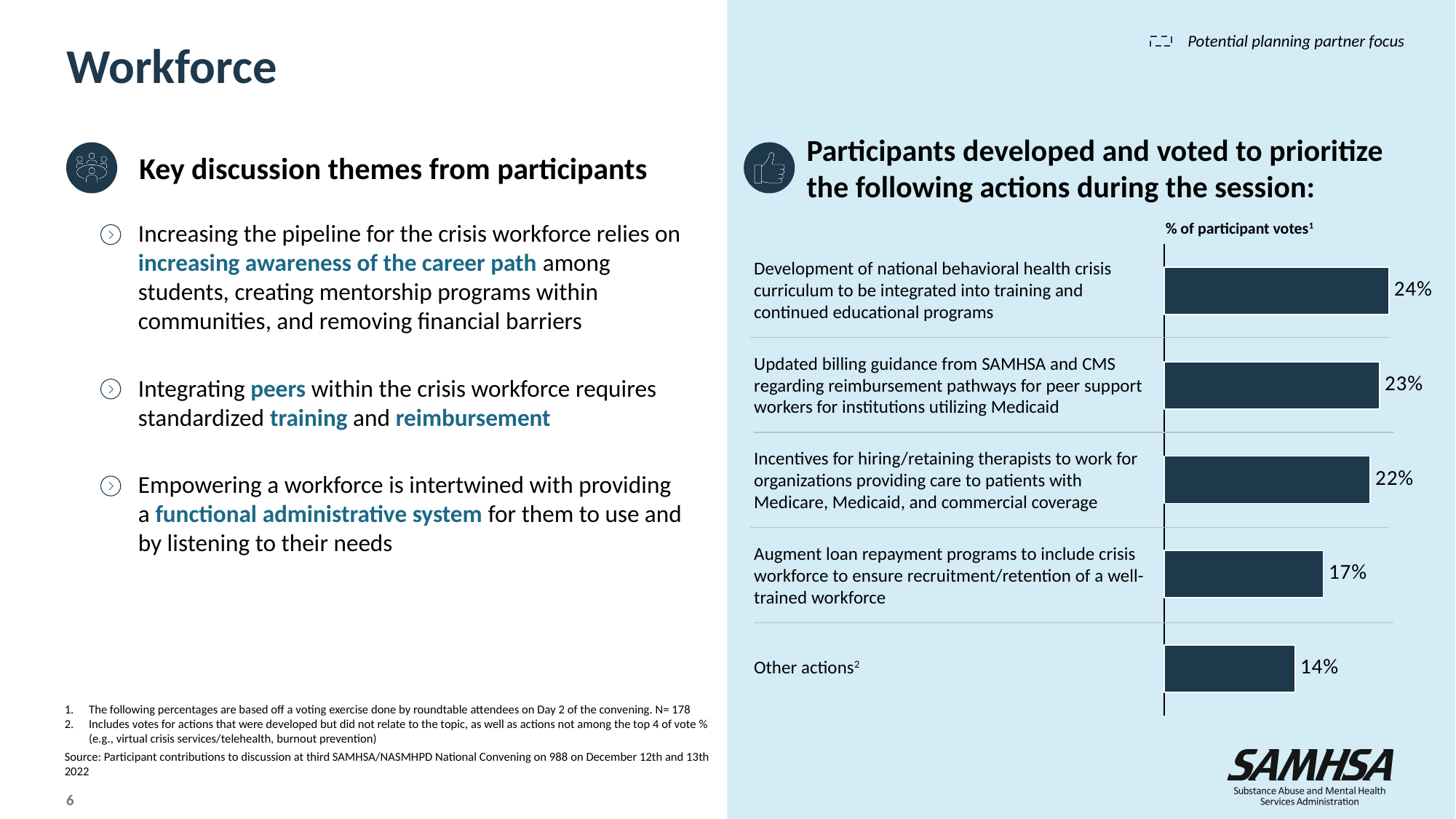
Which action received the highest percentage of participant votes? Development of national behavioral health crisis curriculum to be integrated into training and continued educational programs Which category received the lowest percentage of participant votes? Other actions What is the label above the bars in the chart? % of participant votes What is the difference in percentage of participant votes between the national behavioral health crisis curriculum action and the loan repayment programs action? 7% What percentage of participant votes did 'Other actions' receive? 14% Do the values in the chart rise or fall from the top bar to the bottom bar? Fall Which received a larger share of participant votes: the incentives for hiring/retaining therapists action or the loan repayment programs action? Incentives for hiring/retaining therapists to work for organizations providing care to patients with Medicare, Medicaid, and commercial coverage What percentage of participant votes did 'Augment loan repayment programs to include crisis workforce to ensure recruitment/retention of a well-trained workforce' receive? 17% What is the difference in percentage of participant votes between the updated billing guidance action and the incentives for hiring/retaining therapists action? 1% What type of chart is used to show the percentage of participant votes? Bar chart How many categories are shown in the bar chart? 5 What percentage of participant votes did 'Development of national behavioral health crisis curriculum to be integrated into training and continued educational programs' receive? 24%